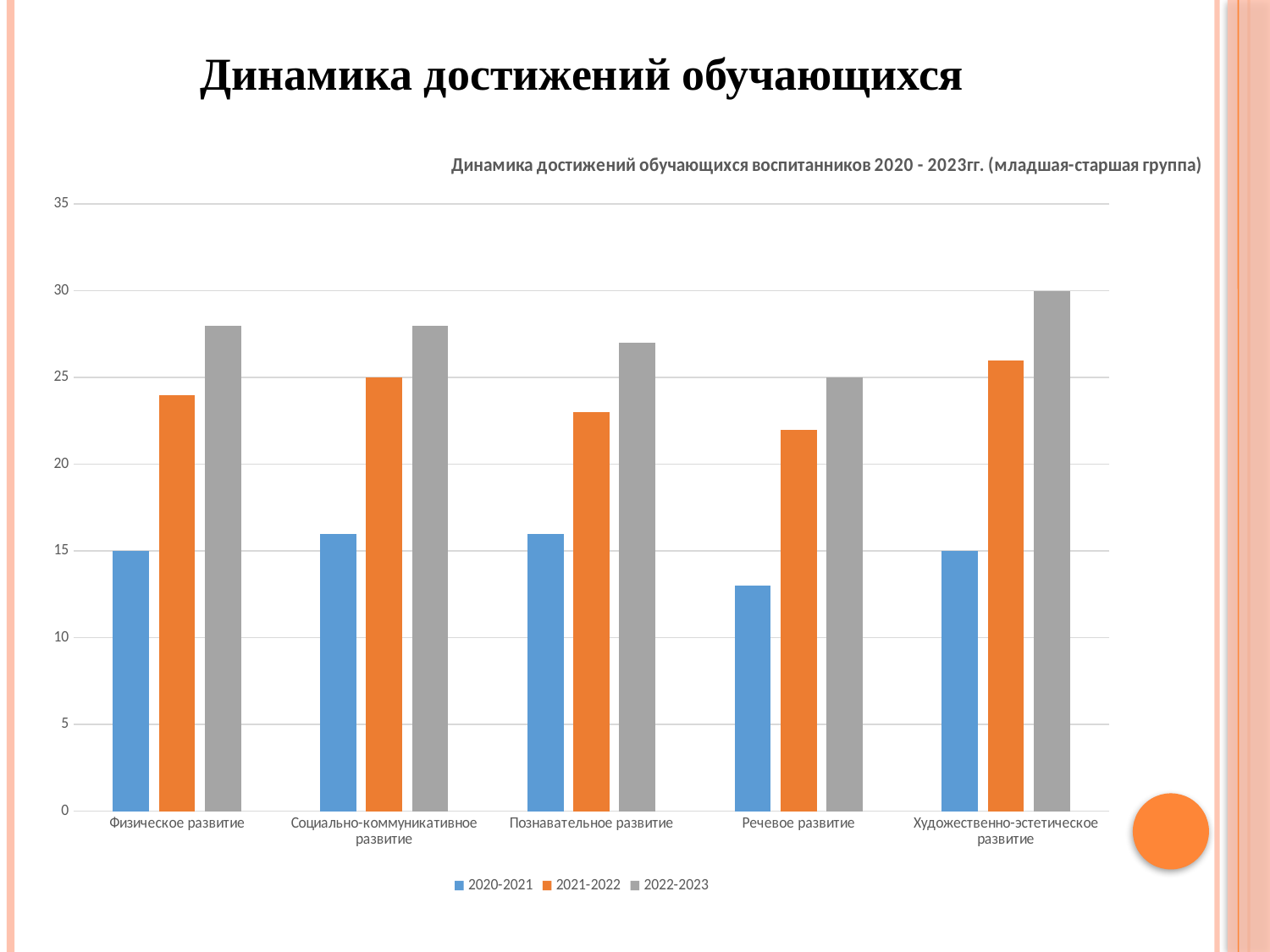
In the 2021-2022 series, which is larger: Художественно-эстетическое развитие or Речевое развитие? Художественно-эстетическое развитие Which series are listed in the chart's legend? 2020-2021, 2021-2022, 2022-2023 Which category has the highest value in the 2022-2023 series? Художественно-эстетическое развитие What kind of chart is shown on the slide? Bar chart For Познавательное развитие, do the values rise or fall from the 2020-2021 series to the 2022-2023 series? rise How many categories are shown on the x axis of the chart? 5 Is the value for Речевое развитие in the 2020-2021 series greater or less than 15? less Is the value for Физическое развитие in the 2022-2023 series greater or less than 25? greater What is the value for Физическое развитие in the 2020-2021 series? 15 How many series does the chart's legend list? 3 Which category has the lowest value in the 2020-2021 series? Речевое развитие What is the value for Художественно-эстетическое развитие in the 2022-2023 series? 30